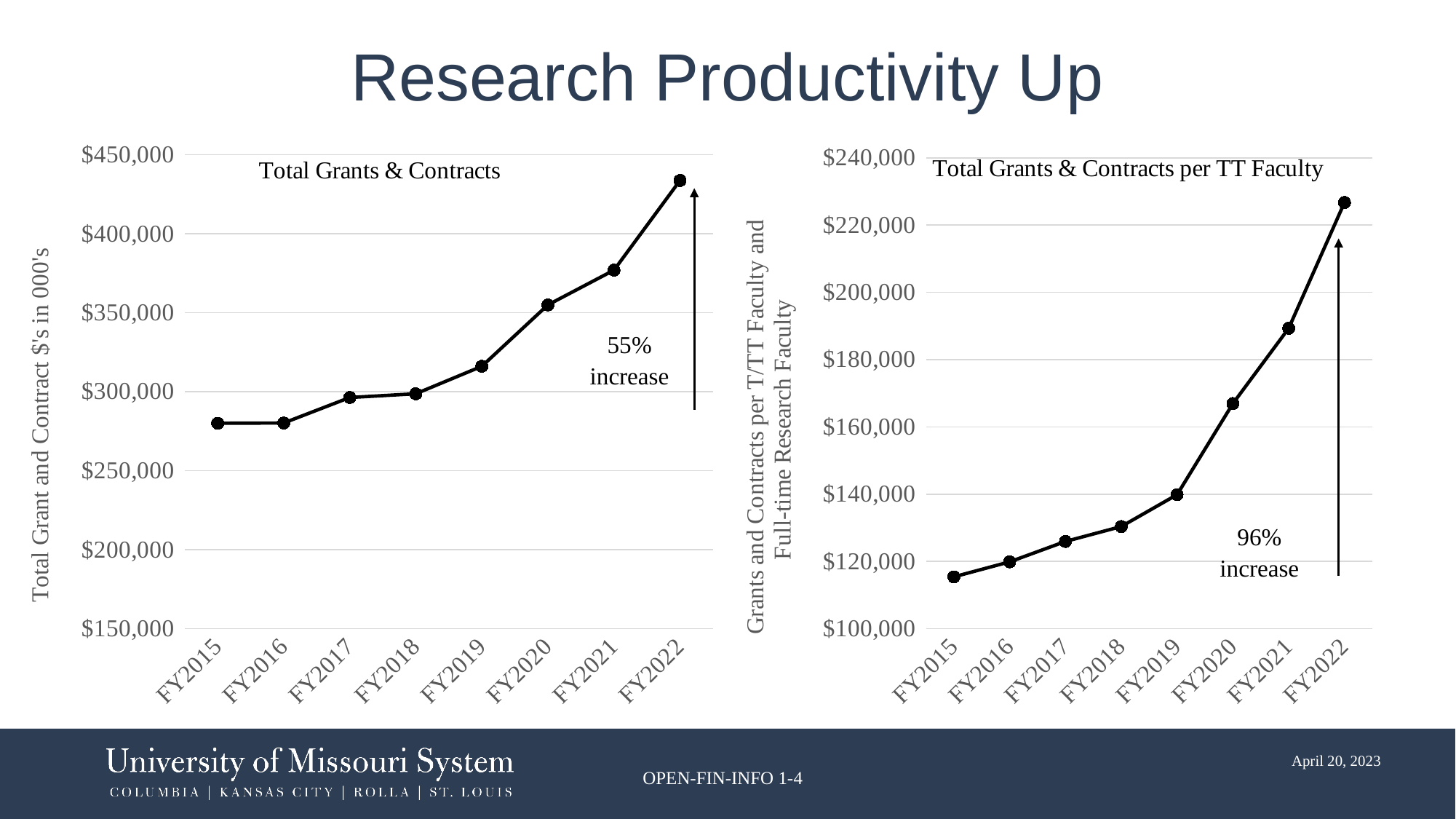
In the 'Total Grants & Contracts' chart, is the value for FY2019 greater or less than $300,000? greater In the 'Total Grants & Contracts' chart, is the value for FY2022 greater or less than $400,000? greater What percentage increase is annotated on the 'Total Grants & Contracts' chart? 55% increase In the 'Total Grants & Contracts' chart, is the value for FY2015 greater or less than $300,000? less In the 'Total Grants & Contracts' chart, do the values generally rise or fall from FY2015 to FY2022? rise In the 'Total Grants & Contracts per TT Faculty' chart, which is larger, the value for FY2019 or the value for FY2021? FY2021 How many fiscal years are plotted in the 'Total Grants & Contracts' chart? 8 In the 'Total Grants & Contracts' chart, which fiscal year has the highest value? FY2022 What kind of chart is the 'Total Grants & Contracts' chart on the left? line chart In the 'Total Grants & Contracts per TT Faculty' chart, which fiscal year has the lowest value? FY2015